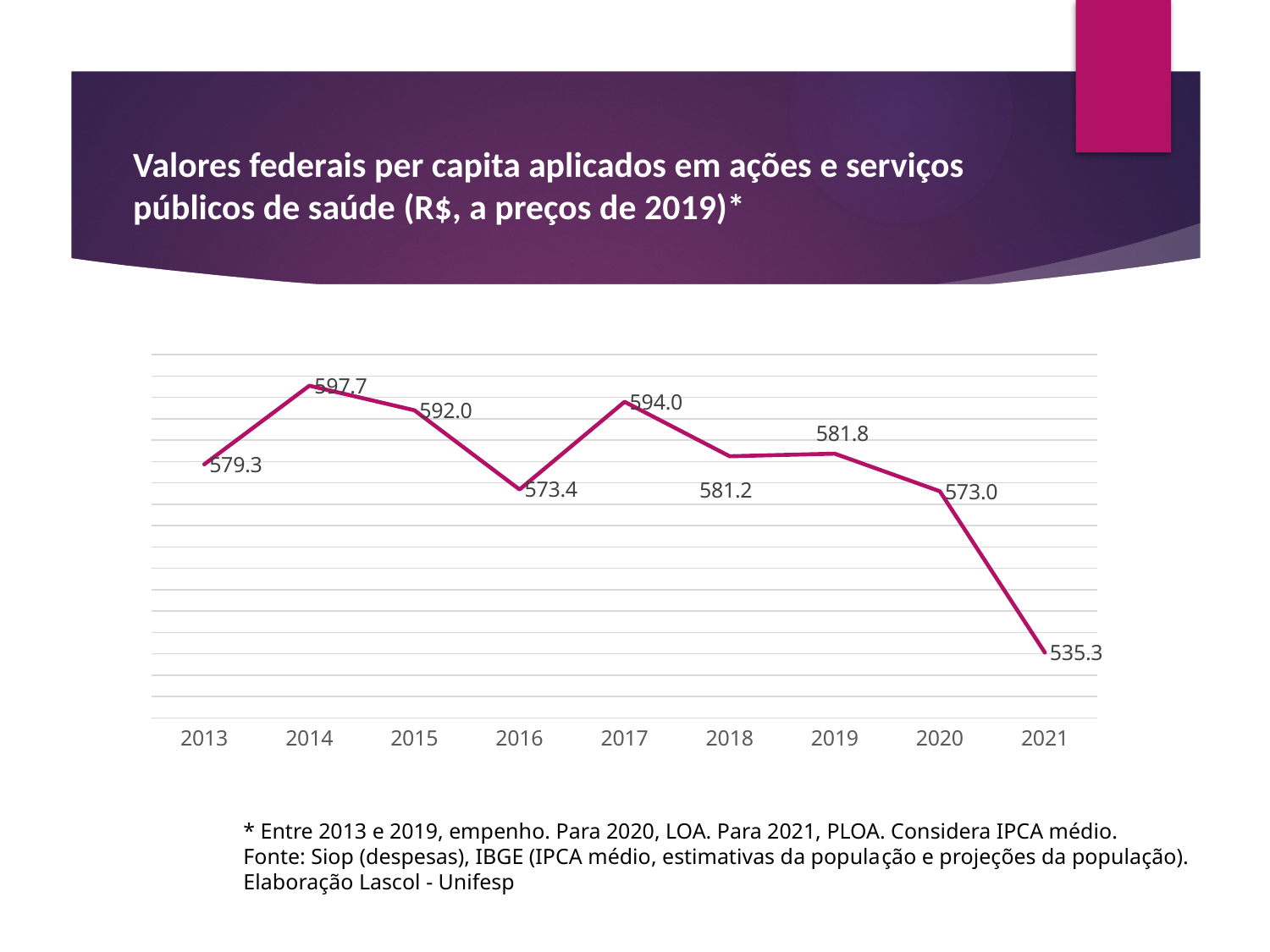
What is the value for 2014? 597.7 Which year has the lowest value? 2021 What is the value for 2019? 581.8 Do the values rise or fall from 2019 to 2021? fall What is the difference between the values for 2017 and 2016? 20.6 How many years are plotted on the x axis? 9 Which year has the highest value? 2014 What type of chart is shown on the slide? line chart Which is larger, the value for 2015 or the value for 2020? 2015 What is the value for 2021? 535.3 What is the difference between the values for 2014 and 2021? 62.4 What is the value for 2016? 573.4